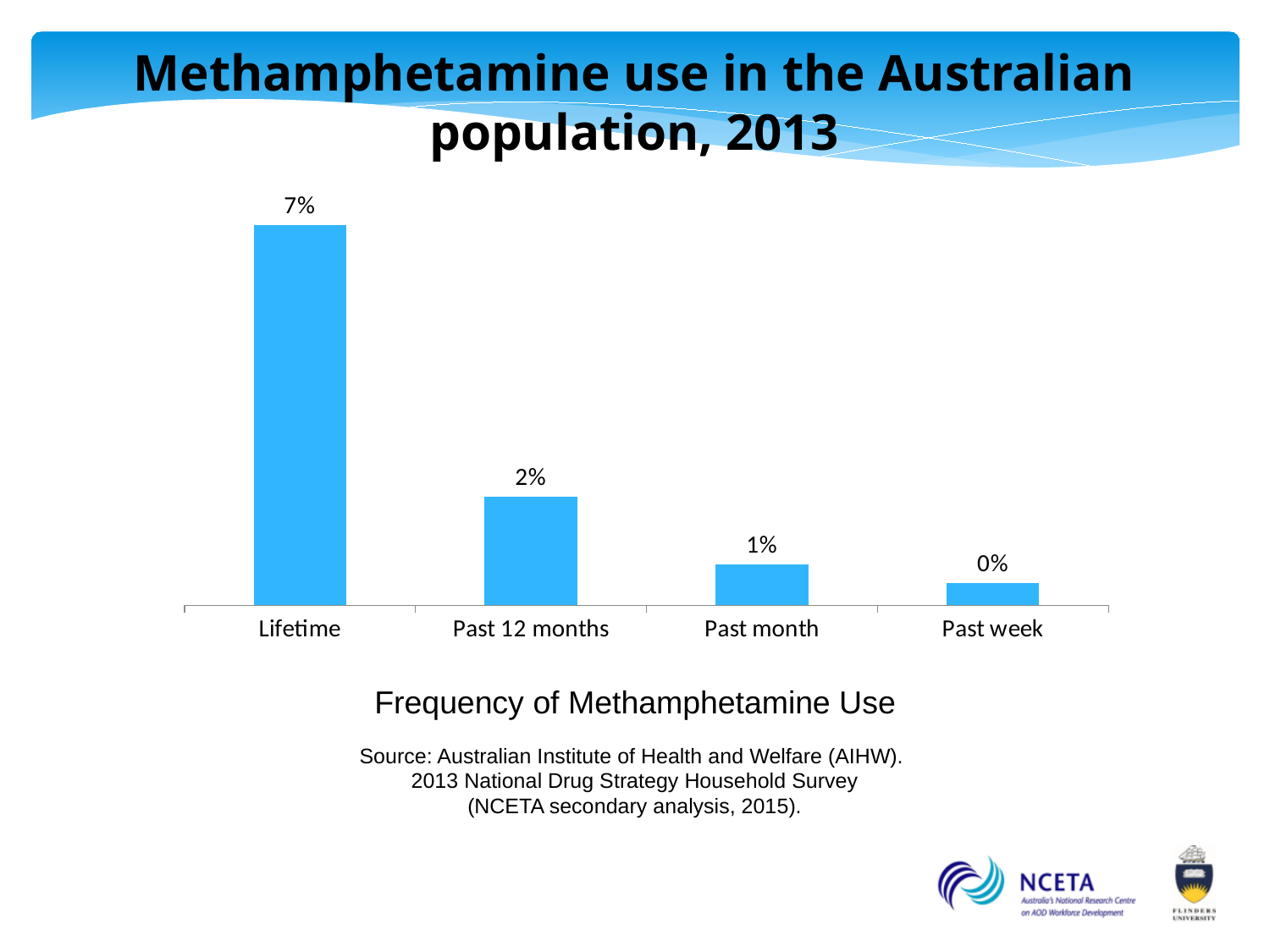
What is the value for Past month? 1% How many categories are shown on the x axis? 4 Which category has the highest value? Lifetime What is the value for Past 12 months? 2% What is the value for Lifetime? 7% What kind of chart is shown on the slide? Bar chart What is the value for Past week? 0% Do the values rise or fall from left to right along the x axis? Fall What is the caption shown below the chart? Frequency of Methamphetamine Use Which category has the lowest value? Past week Which is larger, the value for Past 12 months or the value for Past month? Past 12 months What is the difference between the Lifetime value and the Past 12 months value? 5%